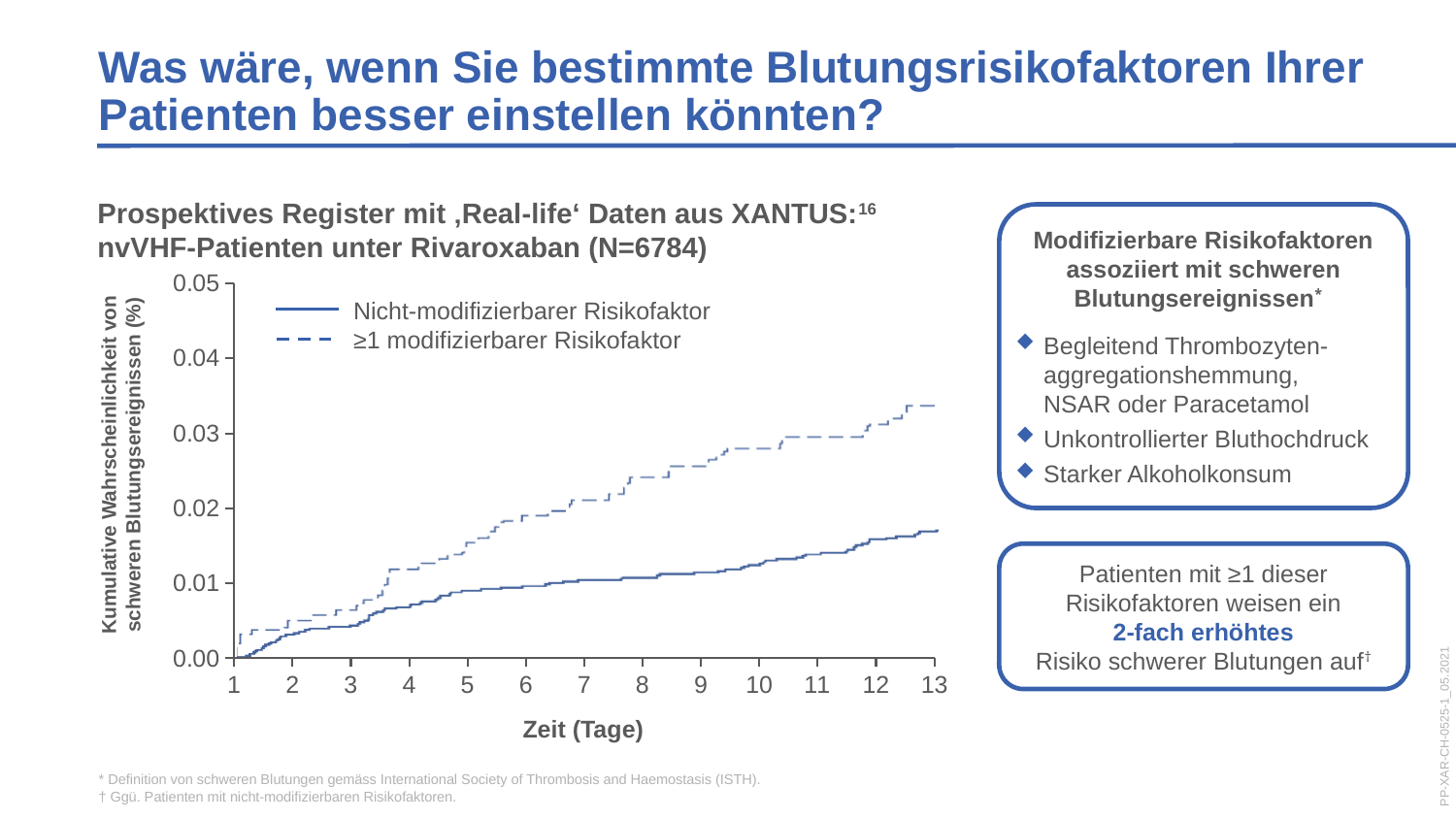
Is the value for 'Nicht-modifizierbarer Risikofaktor' at day 3 greater or less than 0.01? less At day 13, which series has the higher cumulative probability: 'Nicht-modifizierbarer Risikofaktor' or '≥1 modifizierbarer Risikofaktor'? ≥1 modifizierbarer Risikofaktor What kind of chart is shown on the slide? Line chart Do the values for the '≥1 modifizierbarer Risikofaktor' series rise or fall as time increases? Rise Do the values for the 'Nicht-modifizierbarer Risikofaktor' series rise or fall along the x axis? Rise How many series does the chart legend list? 2 Is the value for 'Nicht-modifizierbarer Risikofaktor' at day 13 greater or less than 0.02? less What is the title of the x axis? Zeit (Tage) How many tick labels are shown on the x axis? 13 Is the value for '≥1 modifizierbarer Risikofaktor' at day 13 greater or less than 0.03? greater Which series is drawn with a dashed line? ≥1 modifizierbarer Risikofaktor